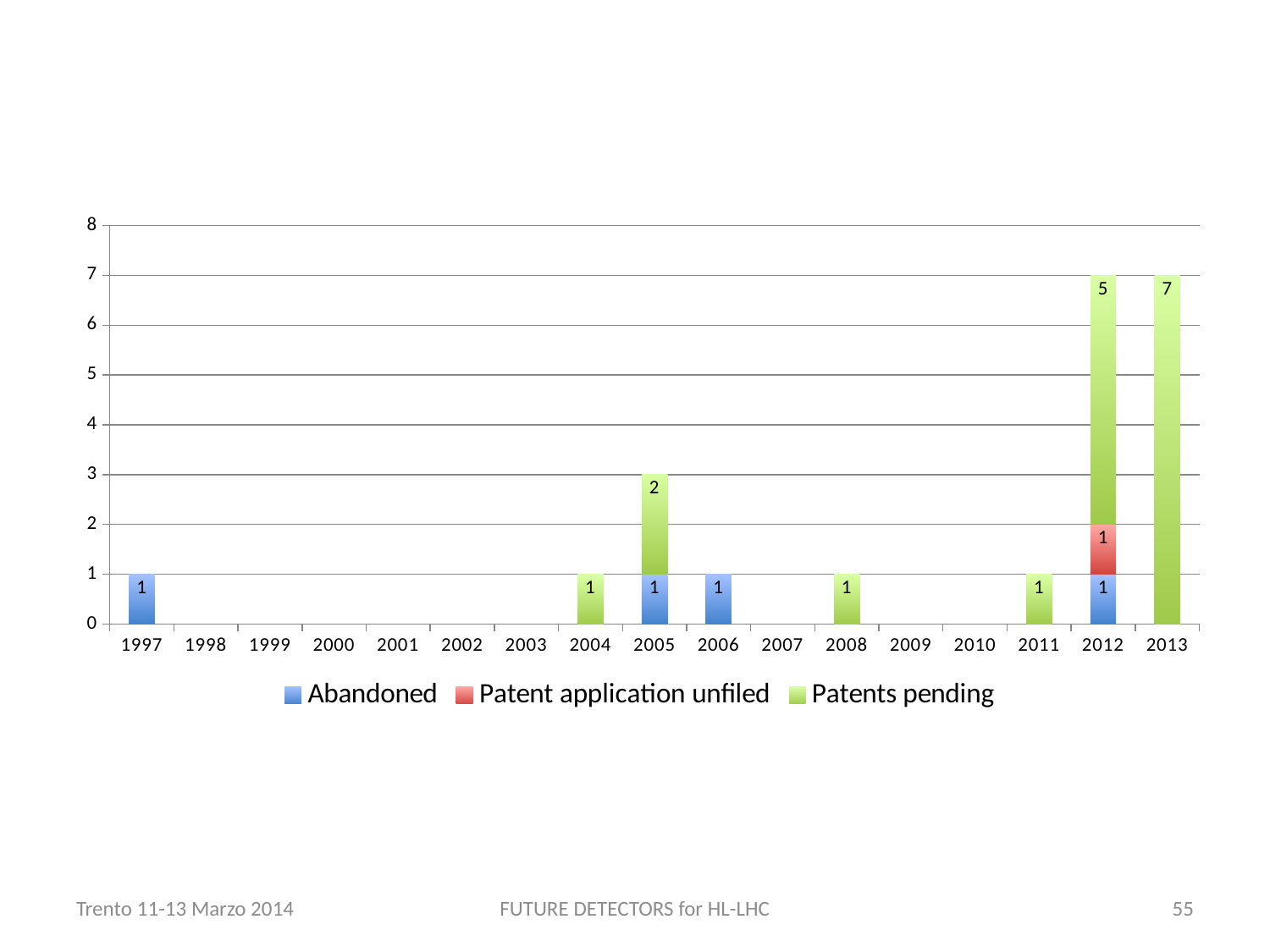
Which year has the highest value for Patents pending? 2013 What is the value for Patents pending in 2012? 5 What is the value for Patents pending in 2005? 2 How many series does the legend list? 3 What is the difference between the Patents pending values for 2013 and 2012? 2 What is the total of the stacked bar for 2005? 3 How many years are shown on the x axis? 17 Which series is shown in red in the legend? Patent application unfiled What is the value for Patents pending in 2013? 7 What kind of chart is shown on the slide? Stacked bar chart What is the value for Patent application unfiled in 2012? 1 What is the total of the stacked bar for 2012? 7